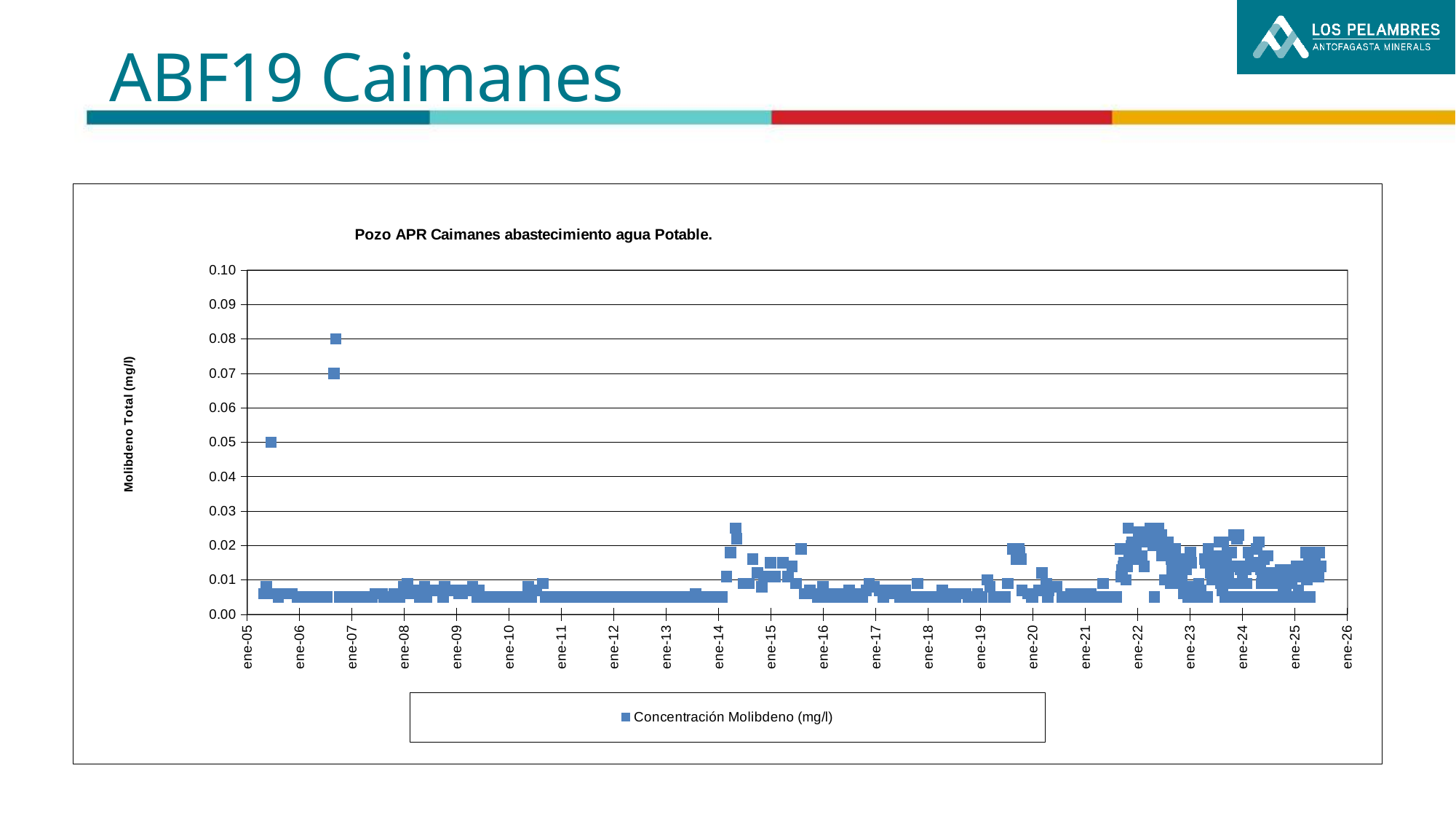
How many series does the legend list? 1 What is the title of the chart? Pozo APR Caimanes abastecimiento agua Potable. Is the highest value plotted after ene-08 greater or less than 0.03? less Is the first value plotted in 2005 greater or less than 0.04? less Are the values plotted around ene-22 higher or lower than those plotted around ene-12? higher Do the values plotted between ene-21 and ene-22 rise or fall along the x axis? rise Is the value plotted around ene-12 greater or less than 0.01? less What series name is shown in the legend? Concentración Molibdeno (mg/l) What is the highest molybdenum concentration value plotted on the chart? 0.08 What kind of chart is shown on the slide? scatter chart